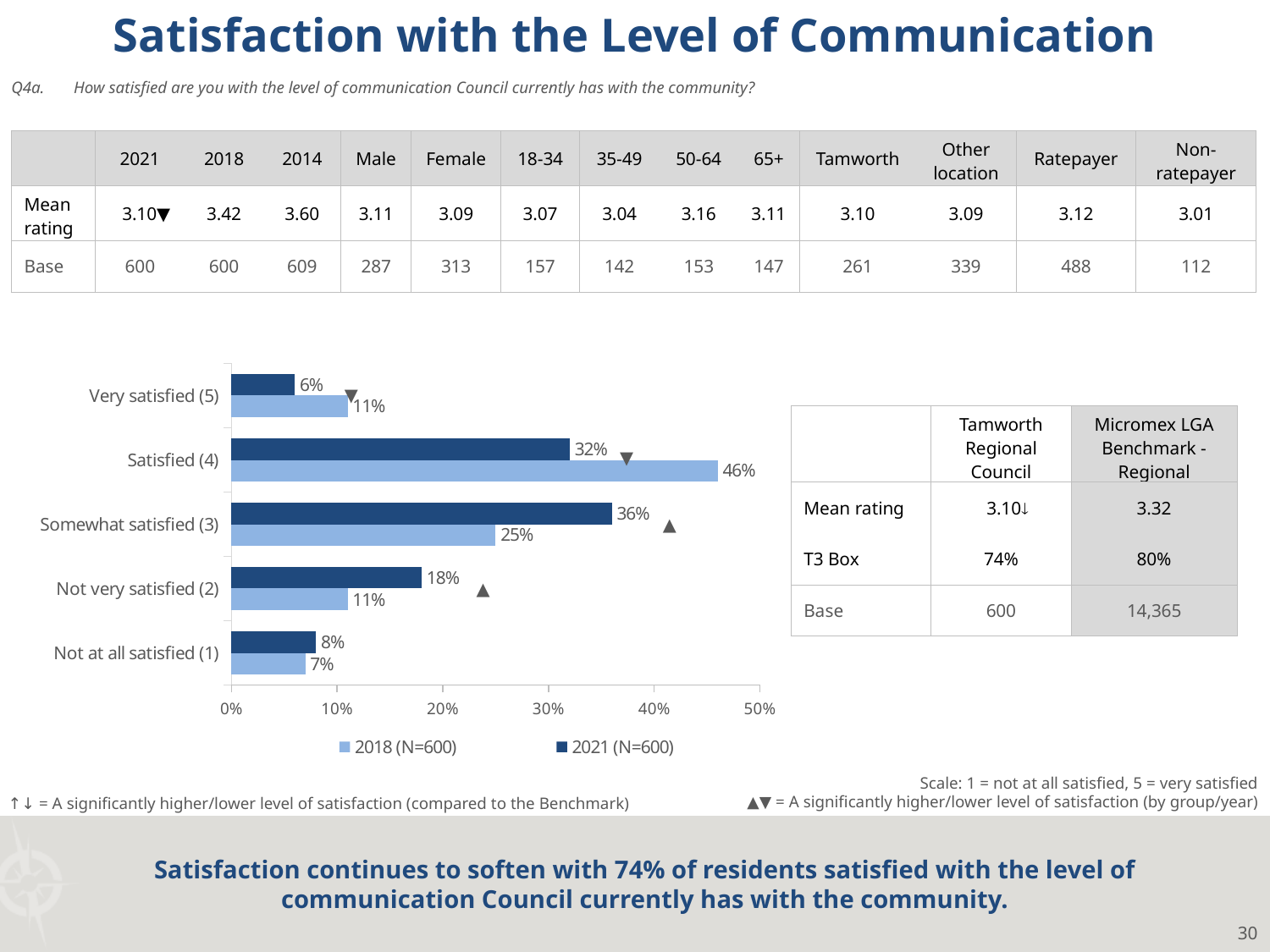
What is the 2021 value for 'Somewhat satisfied (3)'? 36% How many series does the chart legend list? 2 What is the 2018 value for 'Very satisfied (5)'? 11% Which category has the lowest value for the 2018 series? Not at all satisfied (1) What is the difference between the 2018 and 2021 values for 'Satisfied (4)'? 14% What percentage of respondents were 'Satisfied (4)' in 2021? 32% What percentage of respondents were 'Satisfied (4)' in 2018? 46% How many satisfaction categories are shown on the chart? 5 For 'Not very satisfied (2)', which year has the larger value, 2018 or 2021? 2021 Which category has the highest value for the 2021 series? Somewhat satisfied (3) What type of chart is shown on the slide? Bar chart Which series is shown in the darker blue colour? 2021 (N=600)